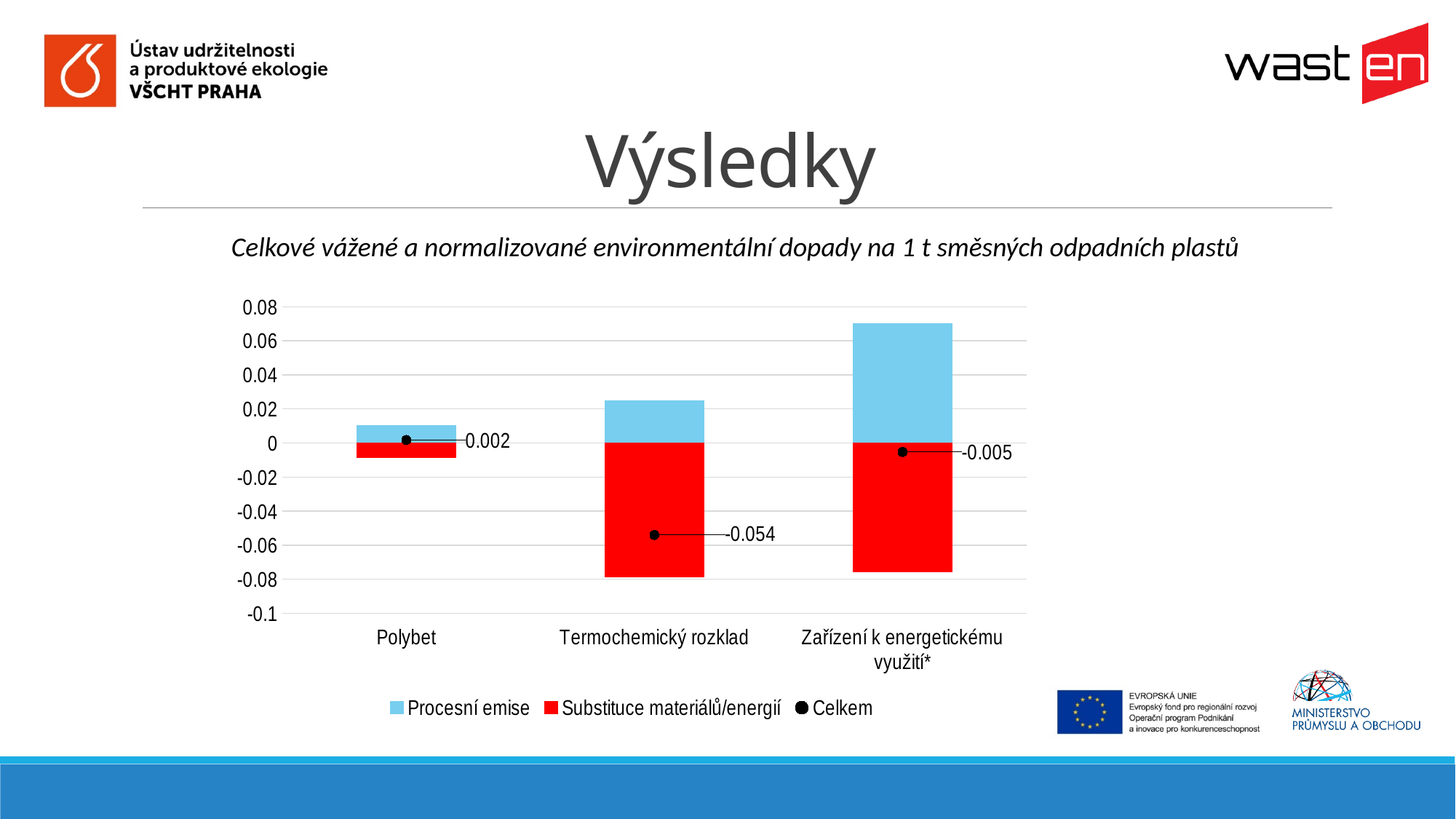
What is the Celkem value for Termochemický rozklad? -0.054 Which category has the highest Celkem value? Polybet Which category has the lowest Celkem value? Termochemický rozklad How many series does the legend list? 3 What is the difference between the Celkem values for Polybet and Termochemický rozklad? 0.056 What is the Celkem value for Polybet? 0.002 Is the Substituce materiálů/energií value for Termochemický rozklad greater or less than -0.06? less How many categories are shown on the x axis? 3 What is the Celkem value for Zařízení k energetickému využití*? -0.005 Is the Procesní emise value for Zařízení k energetickému využití* greater or less than 0.06? greater Which has the larger Celkem value, Polybet or Zařízení k energetickému využití*? Polybet What kind of chart is shown on the slide? bar chart